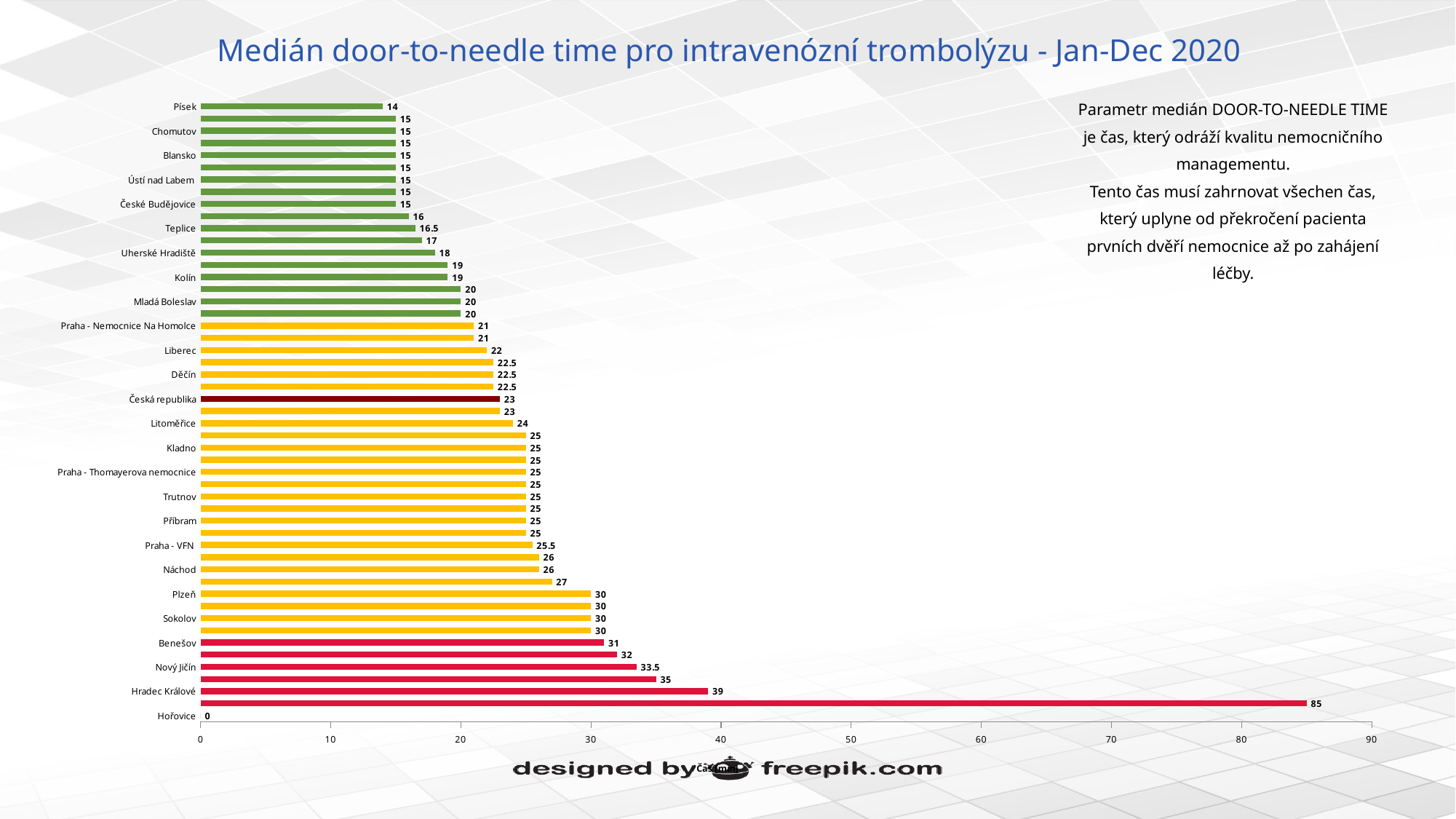
What is the value shown for Nový Jičín? 33.5 What is the largest value labelled on any bar in the chart? 85 Is the value for Benešov greater or less than 20? greater What is the difference between the values for Hradec Králové and Písek? 25 What is the value shown for Teplice? 16.5 What is the title of the chart? Medián door-to-needle time pro intravenózní trombolýzu - Jan-Dec 2020 Which has a higher value, Plzeň or Liberec? Plzeň What is the median door-to-needle time for Písek? 14 What is the value shown for Hradec Králové? 39 Do the bar values generally increase or decrease going from the top of the chart to the bottom? increase What is the value shown for Česká republika? 23 What type of chart is shown on the slide? bar chart